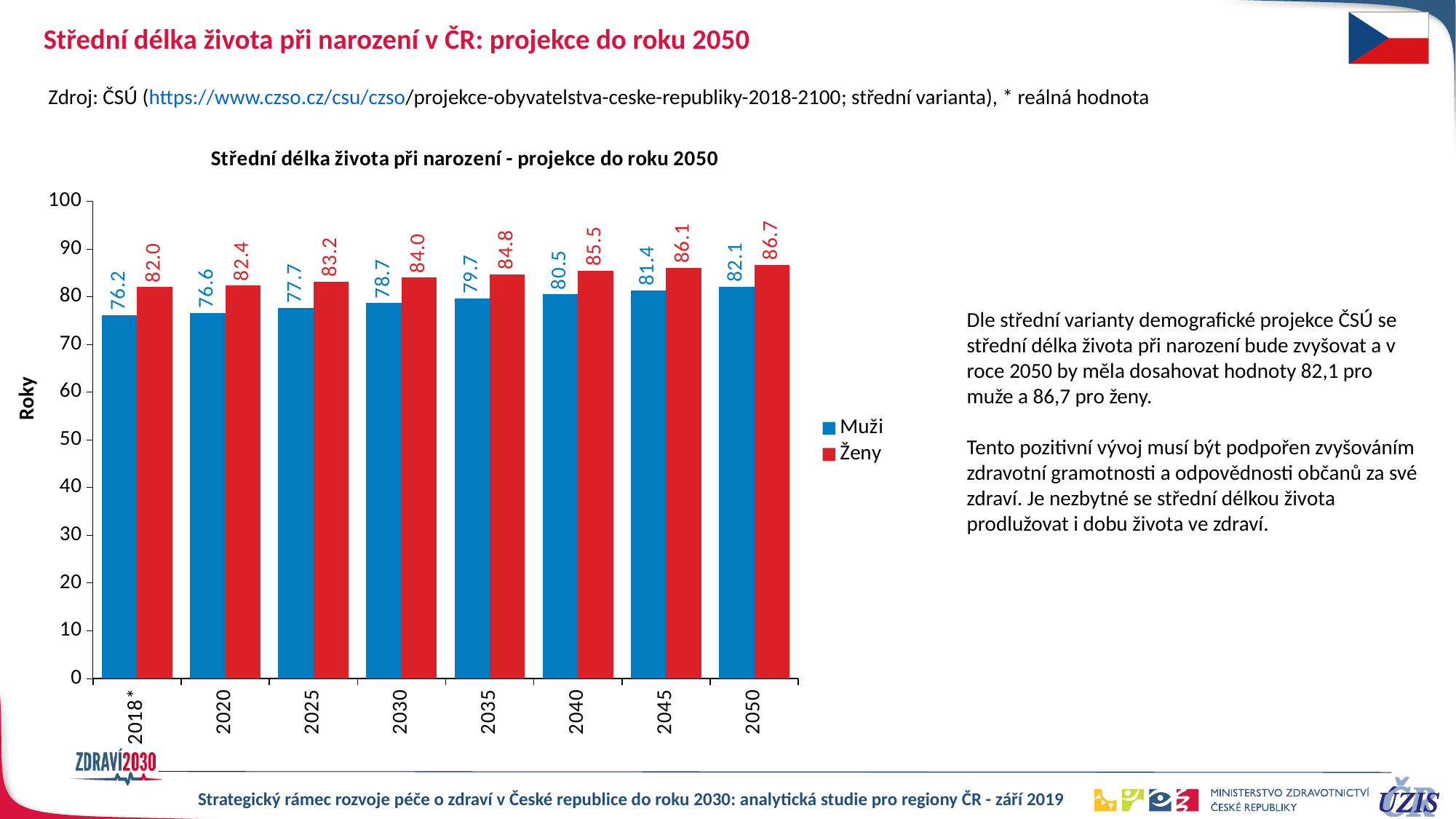
What is the value for Muži in 2018*? 76.2 Which is larger in 2025: the Muži value or the Ženy value? Ženy What is the difference between the Ženy and Muži values in 2050? 4.6 In which year is the Muži value lowest? 2018* Do the Muži values rise or fall from 2018* to 2050? rise What kind of chart is shown? bar chart How many series does the legend list? 2 How many years are shown on the x axis? 8 What is the value for Muži in 2040? 80.5 What is the value for Ženy in 2030? 84.0 What is the value for Ženy in 2050? 86.7 In which year is the Ženy value highest? 2050